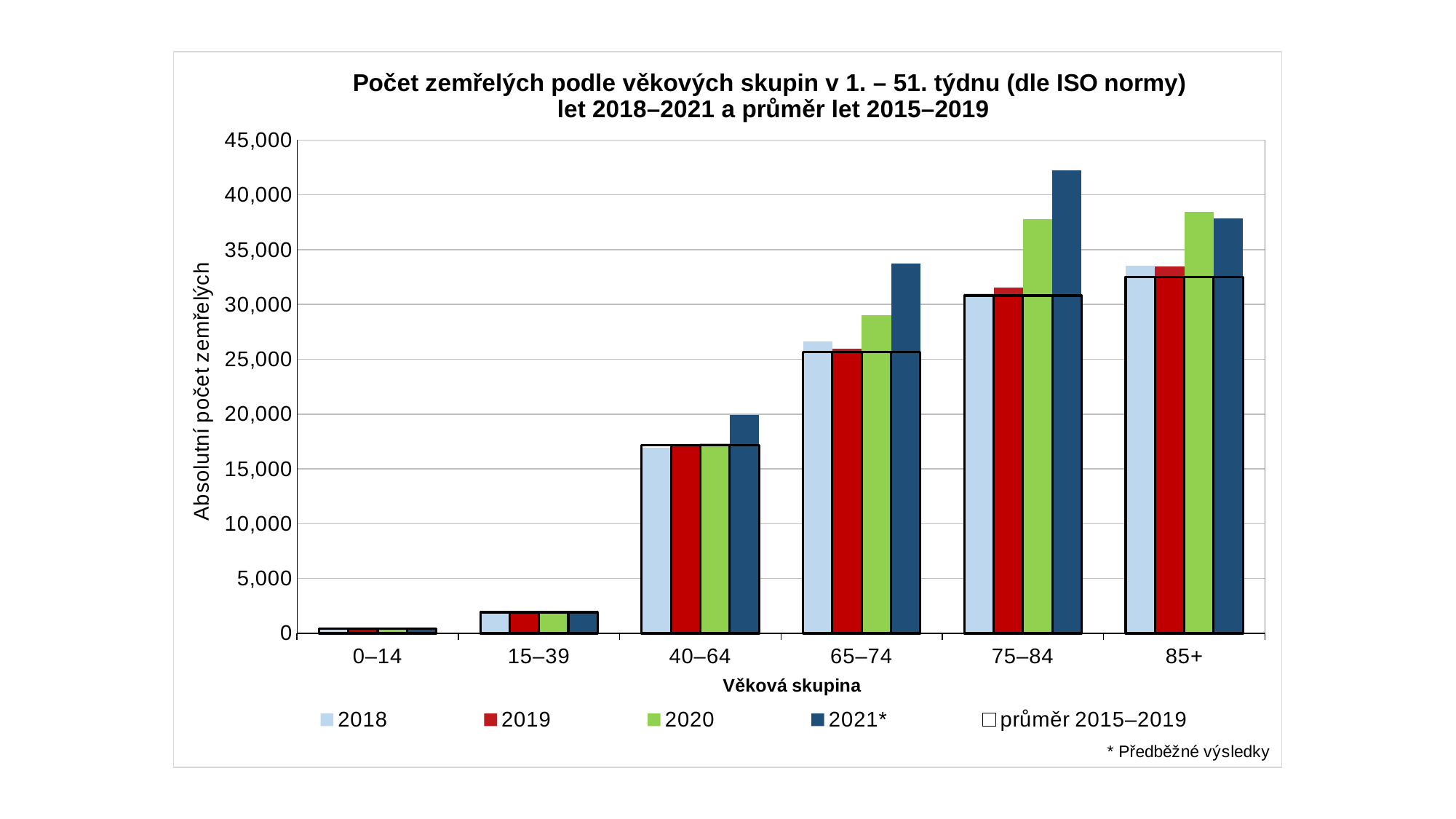
What kind of chart is shown on the slide? bar chart Which age group has the highest value for the 2021* series? 75–84 How many age groups are shown on the x axis? 6 Is the 2021* value for the 65–74 age group greater or less than 30,000? greater How many series does the legend list? 5 Do the 2018 values rise or fall along the x axis from the 0–14 group to the 85+ group? rise Is the 2020 value for the 85+ age group greater or less than 35,000? greater Is the 2021* value for the 75–84 age group greater or less than 40,000? greater For the 75–84 age group, which is larger: the 2020 value or the 2021* value? 2021* For the 65–74 age group, which is larger: the 2018 value or the 2021* value? 2021* Which age group has the lowest value for the 2018 series? 0–14